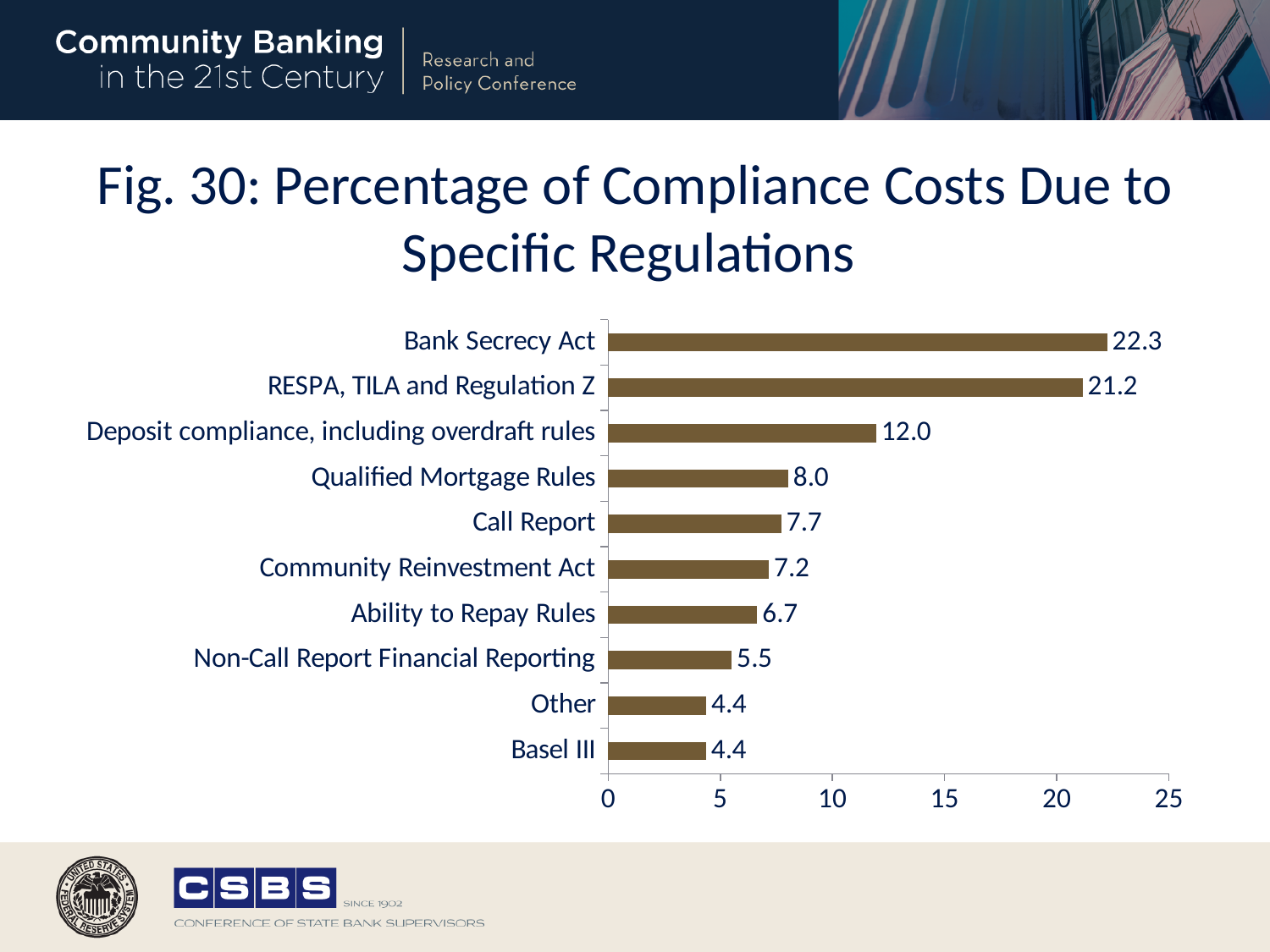
Which is larger, the value for Community Reinvestment Act or the value for Non-Call Report Financial Reporting? Community Reinvestment Act What is the value for Deposit compliance, including overdraft rules? 12.0 How many categories are shown in the chart? 10 Is the value for Basel III greater or less than 5? less What is the value for Call Report? 7.7 What is the difference between the values for Qualified Mortgage Rules and Ability to Repay Rules? 1.3 What kind of chart is shown on the slide? Bar chart What is the difference between the values for Bank Secrecy Act and RESPA, TILA and Regulation Z? 1.1 What is the value for Bank Secrecy Act? 22.3 Is the value for Deposit compliance, including overdraft rules greater or less than 10? greater Which category has the highest value? Bank Secrecy Act What is the title of the chart? Fig. 30: Percentage of Compliance Costs Due to Specific Regulations